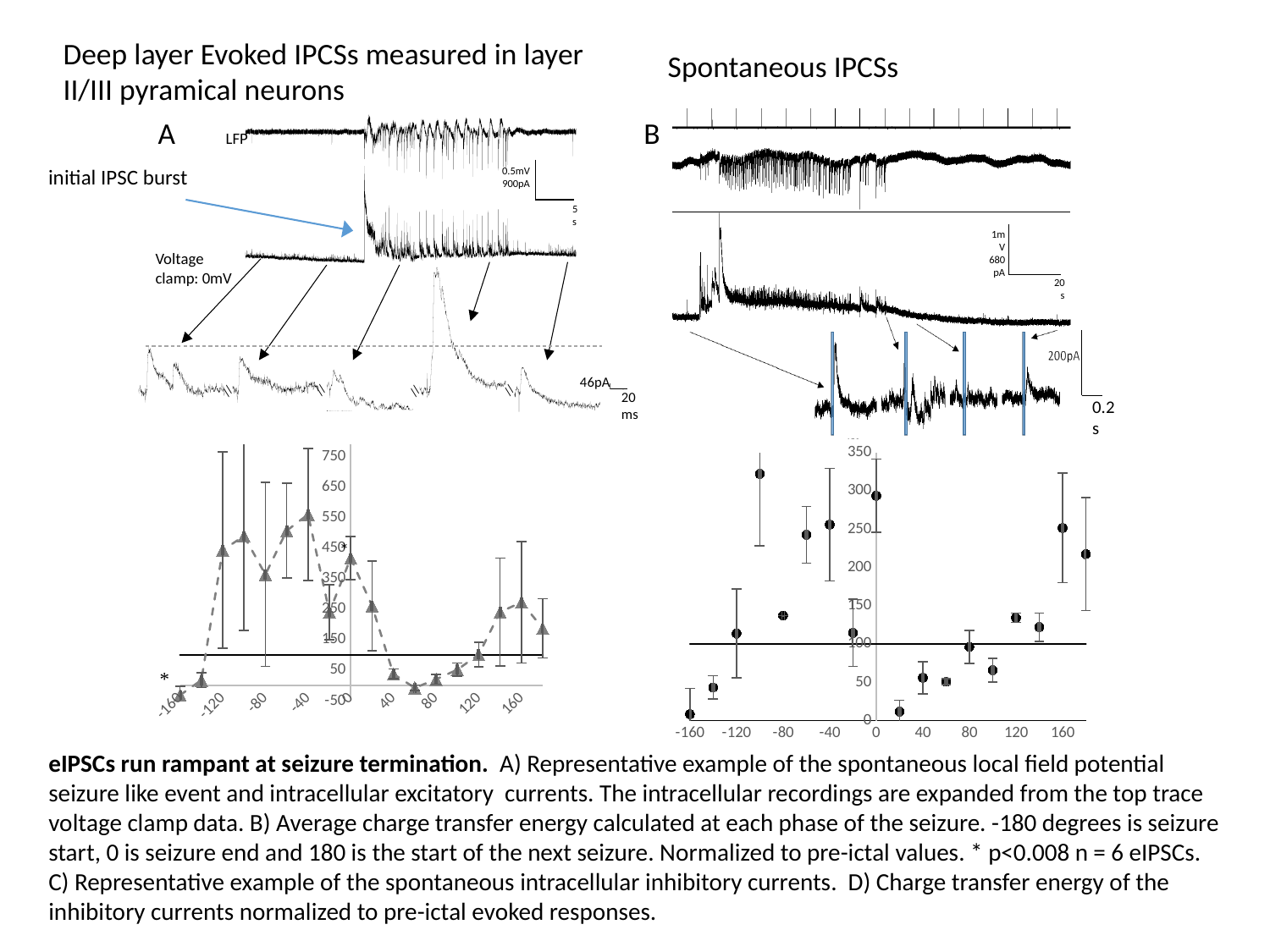
In the bottom-left chart, what is the highest value shown on the y axis? 750 In the bottom-right chart, is the value at x = 20 greater or less than 50? less In the bottom-left chart, which is larger, the value at x = -40 or the value at x = 40? -40 In the bottom-right chart, is the value at x = -100 greater or less than 250? greater In the bottom-right chart, is the value at x = 0 greater or less than 250? greater In the bottom-right chart, what is the highest value shown on the y axis? 350 In the bottom-left chart, do the values rise or fall from x = 40 to x = 140? rise In the bottom-right chart, do the values rise or fall from x = 20 to x = 160? rise In the bottom-right chart, which is larger, the value at x = -100 or the value at x = -160? -100 What kind of chart is the bottom-right chart? scatter chart with error bars